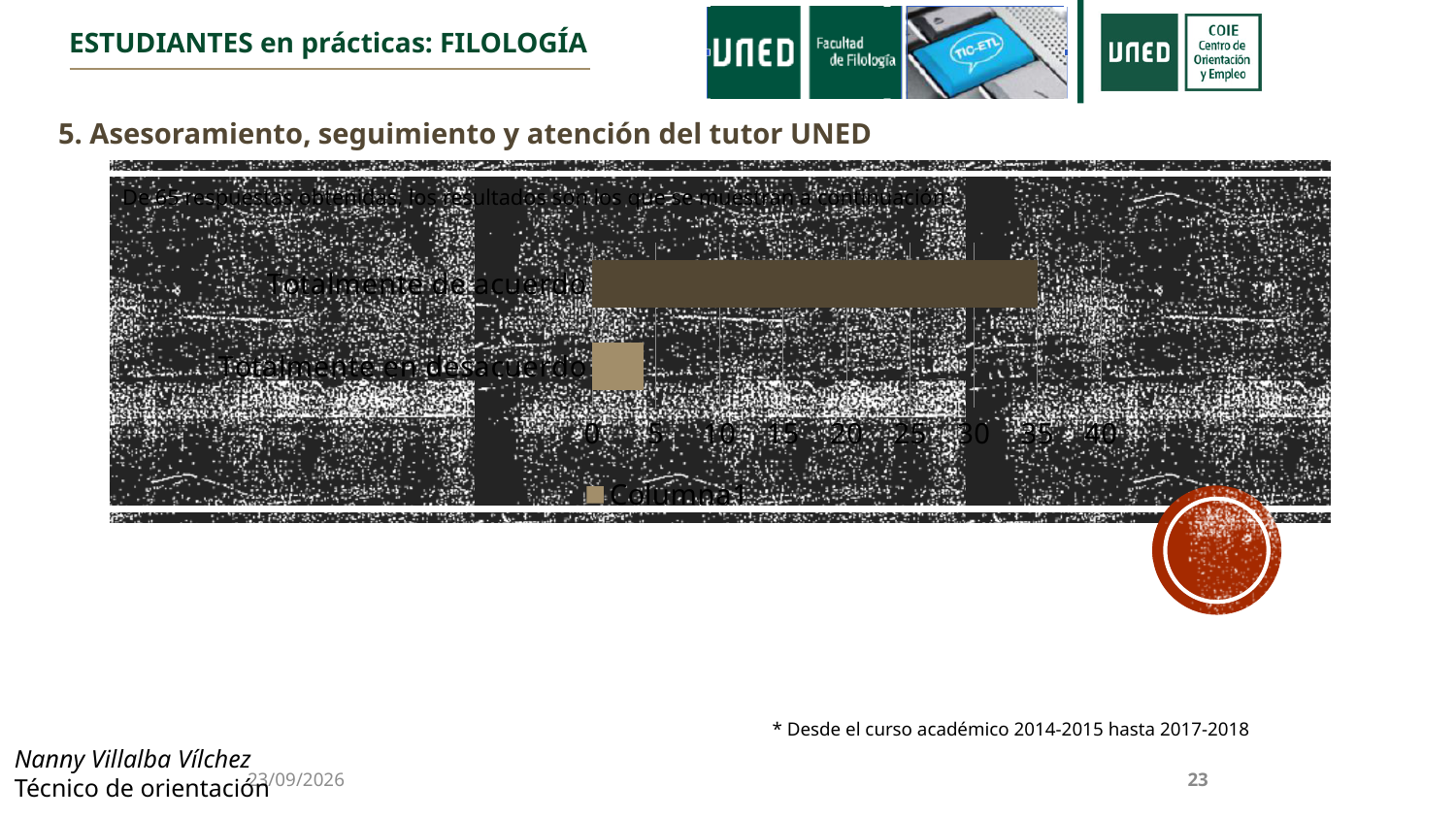
Is the value for Totalmente de acuerdo greater or less than 40? less What is the highest value shown on the horizontal axis of the chart? 40 How many series does the chart legend list? 1 What is the name of the series shown in the legend? Columna1 Which is larger, the value for Totalmente de acuerdo or the value for Totalmente en desacuerdo? Totalmente de acuerdo What kind of chart is shown on the slide? bar chart Which category has the lowest value in the chart? Totalmente en desacuerdo Is the value for Totalmente en desacuerdo greater or less than 5? less Is the value for Totalmente en desacuerdo greater or less than 10? less How many categories are plotted in the chart? 2 Which category has the highest value in the chart? Totalmente de acuerdo